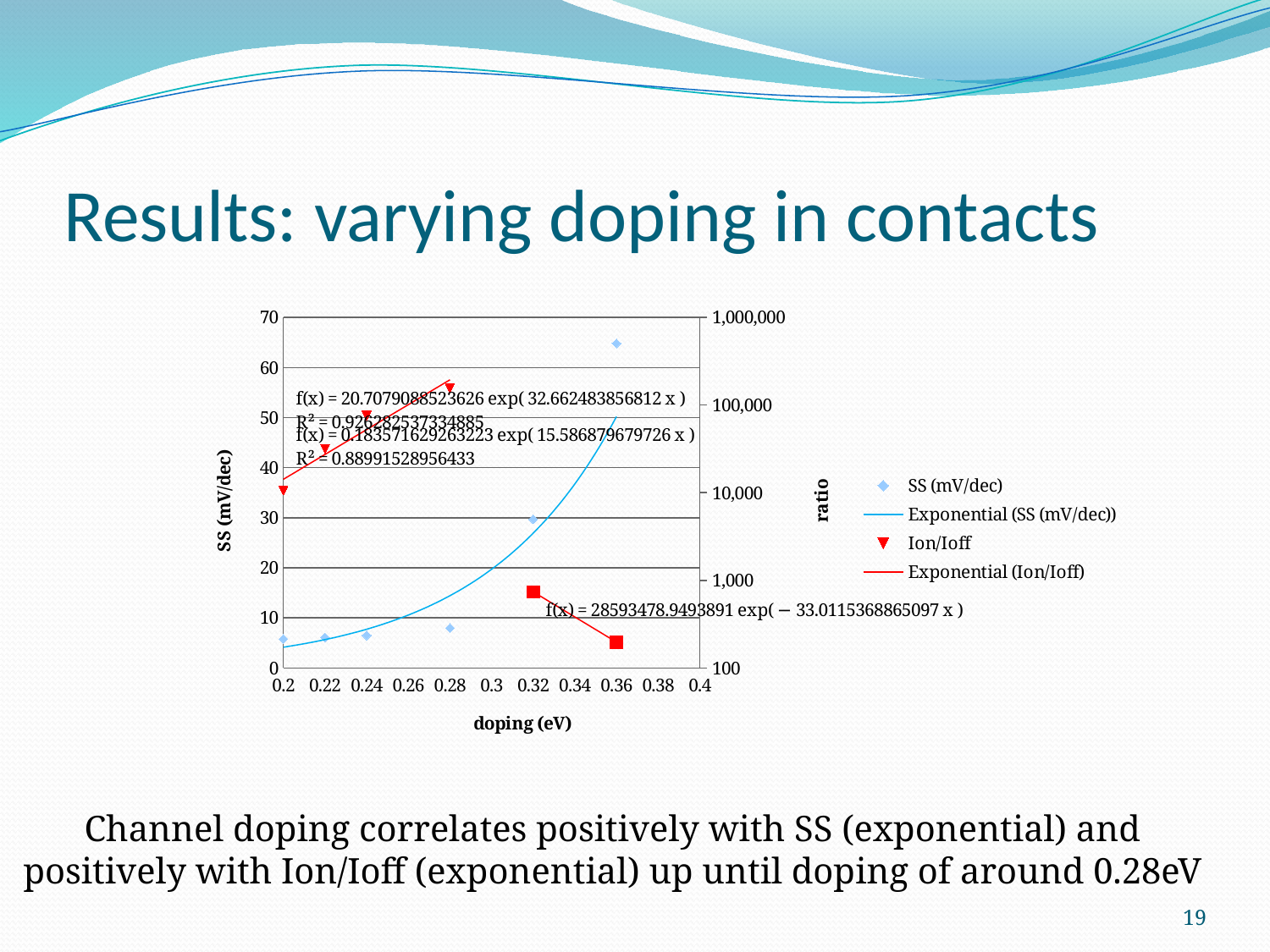
How many entries does the chart legend list? 4 Do the SS (mV/dec) values rise or fall as doping increases along the x axis? rise What is the label of the right-hand vertical axis of the chart? ratio What is the title of the x axis of the chart? doping (eV) Is the SS (mV/dec) value at doping 0.28 greater or less than 10? less What kind of chart is shown on the slide? scatter chart How many SS (mV/dec) data points are plotted on the chart? 6 Which has the larger SS (mV/dec) value, doping 0.32 or doping 0.36? 0.36 At which doping value is SS (mV/dec) highest? 0.36 Is the SS (mV/dec) value at doping 0.36 greater or less than 60? greater Is the SS (mV/dec) value at doping 0.32 greater or less than 40? less